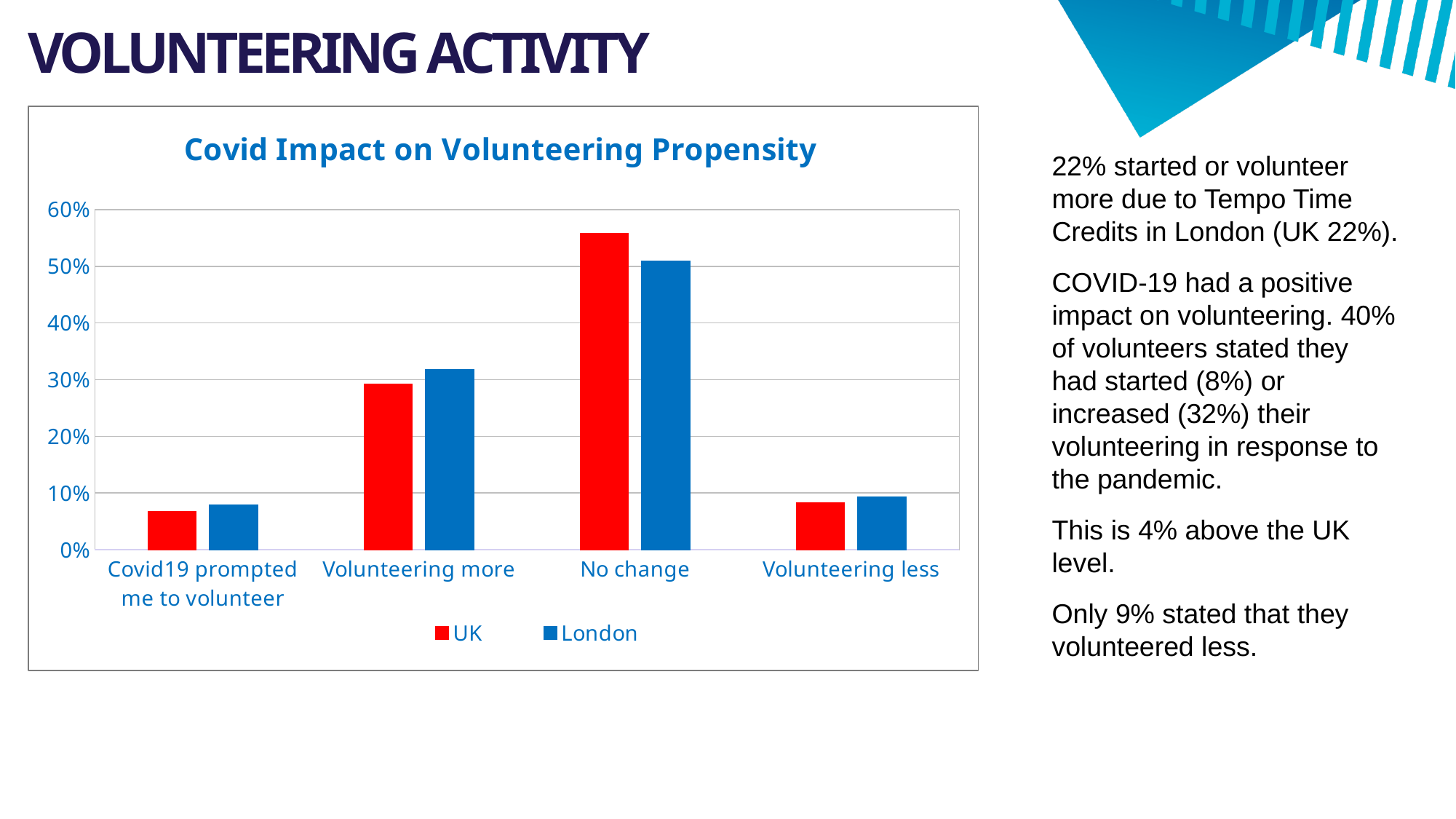
Is the UK value for 'Covid19 prompted me to volunteer' greater or less than 10%? less For the 'Volunteering more' category, which is larger: the UK value or the London value? London How many series does the chart's legend list? 2 Is the UK value for 'Volunteering more' greater or less than 20%? greater How many categories are shown on the x axis of the chart? 4 Which colour represents the London series in the chart? Blue What kind of chart is shown on the slide? Bar chart Is the UK value for 'No change' greater or less than 50%? greater Which category has the highest value for the London series? No change What is the title of the chart? Covid Impact on Volunteering Propensity Which category has the highest value for the UK series? No change For the 'No change' category, which is larger: the UK value or the London value? UK